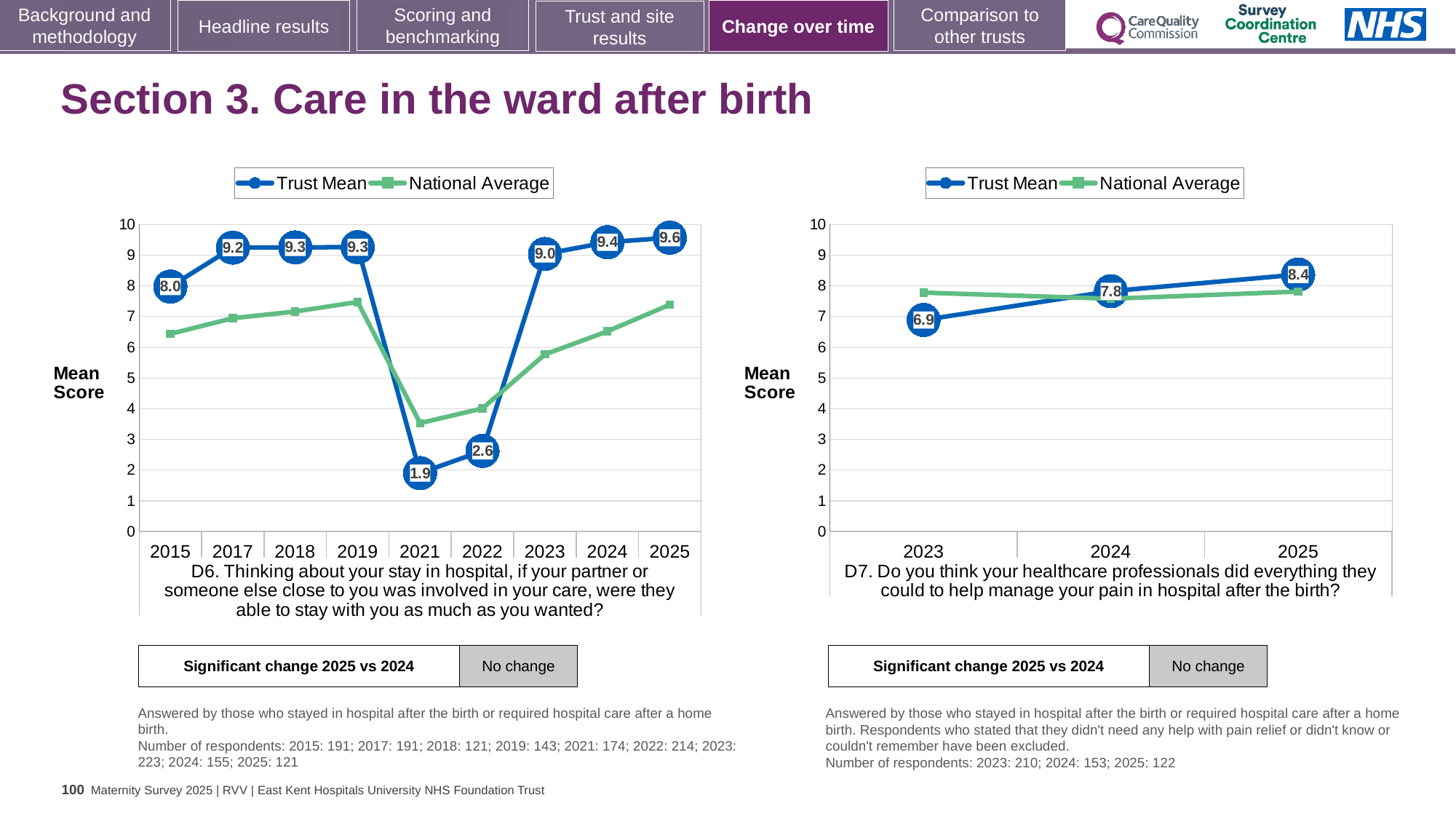
In the left chart (D6), is the National Average for 2021 greater or less than 4? less In the right chart (D7), does the Trust Mean rise or fall from 2023 to 2025? rise In the right chart (D7), how many series does the legend list? 2 In the left chart (D6), what is the Trust Mean score for 2021? 1.9 In the right chart (D7), what is the Trust Mean score for 2023? 6.9 In the right chart (D7), what is the difference between the Trust Mean scores for 2025 and 2023? 1.5 What type of chart is the right chart (D7)? line chart In the left chart (D6), how many years are shown on the x axis? 9 In the left chart (D6), what is the difference between the Trust Mean scores for 2022 and 2021? 0.7 In the left chart (D6), which year has the highest Trust Mean score? 2025 In the left chart (D6), which year has the lowest Trust Mean score? 2021 In the left chart (D6), what is the Trust Mean score for 2025? 9.6